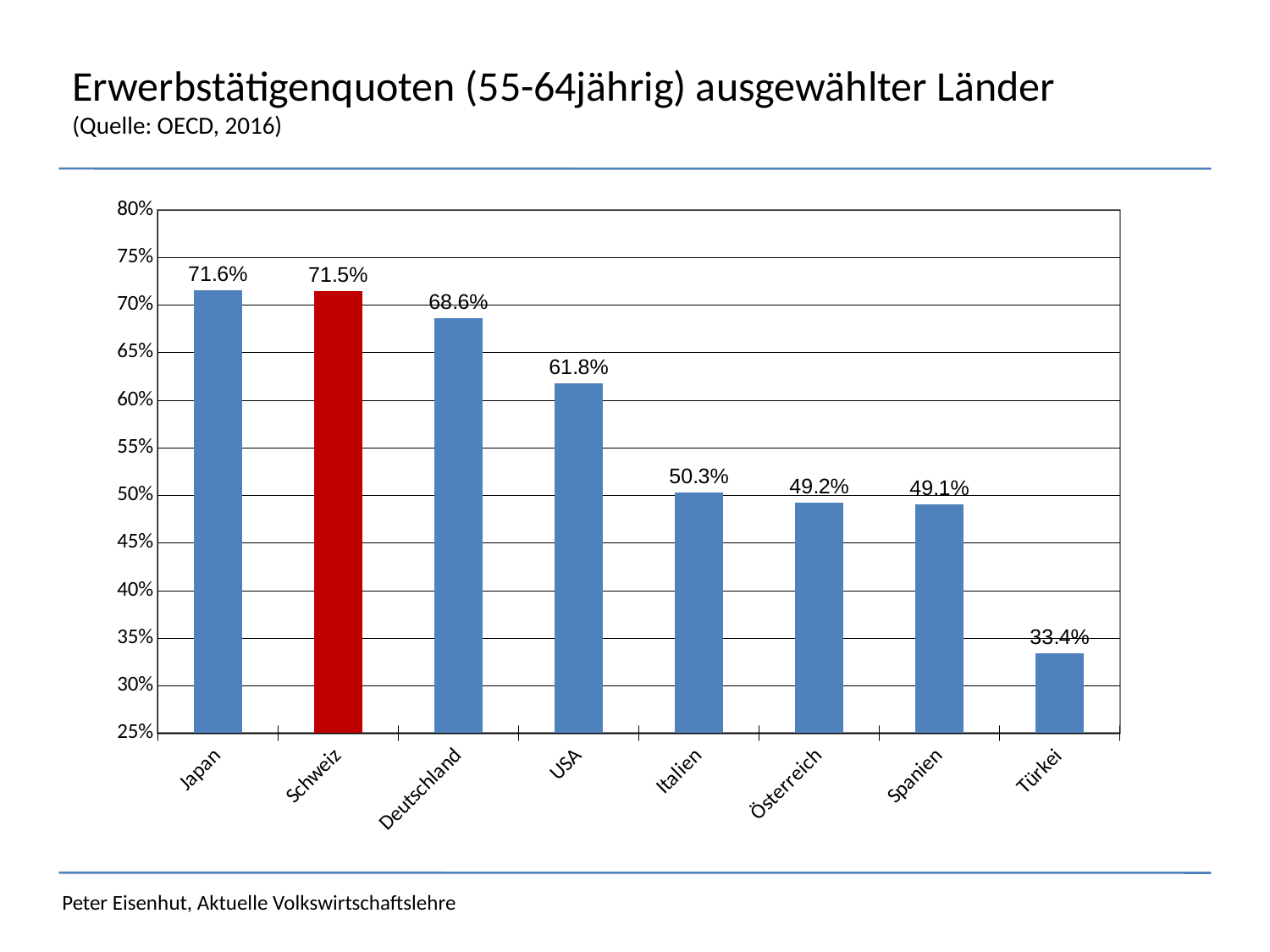
How many countries are shown in the chart? 8 What is the employment rate shown for Deutschland? 68.6% What value is shown for Türkei? 33.4% Is the value for USA greater or less than 60%? greater What is the difference between the values for Deutschland and USA? 6.8 percentage points What is the value for Italien? 50.3% Which country's bar is coloured red? Schweiz What kind of chart is shown on the slide? Bar chart Which has a higher value, USA or Italien? USA Which country has the highest value in the chart? Japan Which country has the lowest value in the chart? Türkei What is the difference between the values for Japan and Türkei? 38.2 percentage points